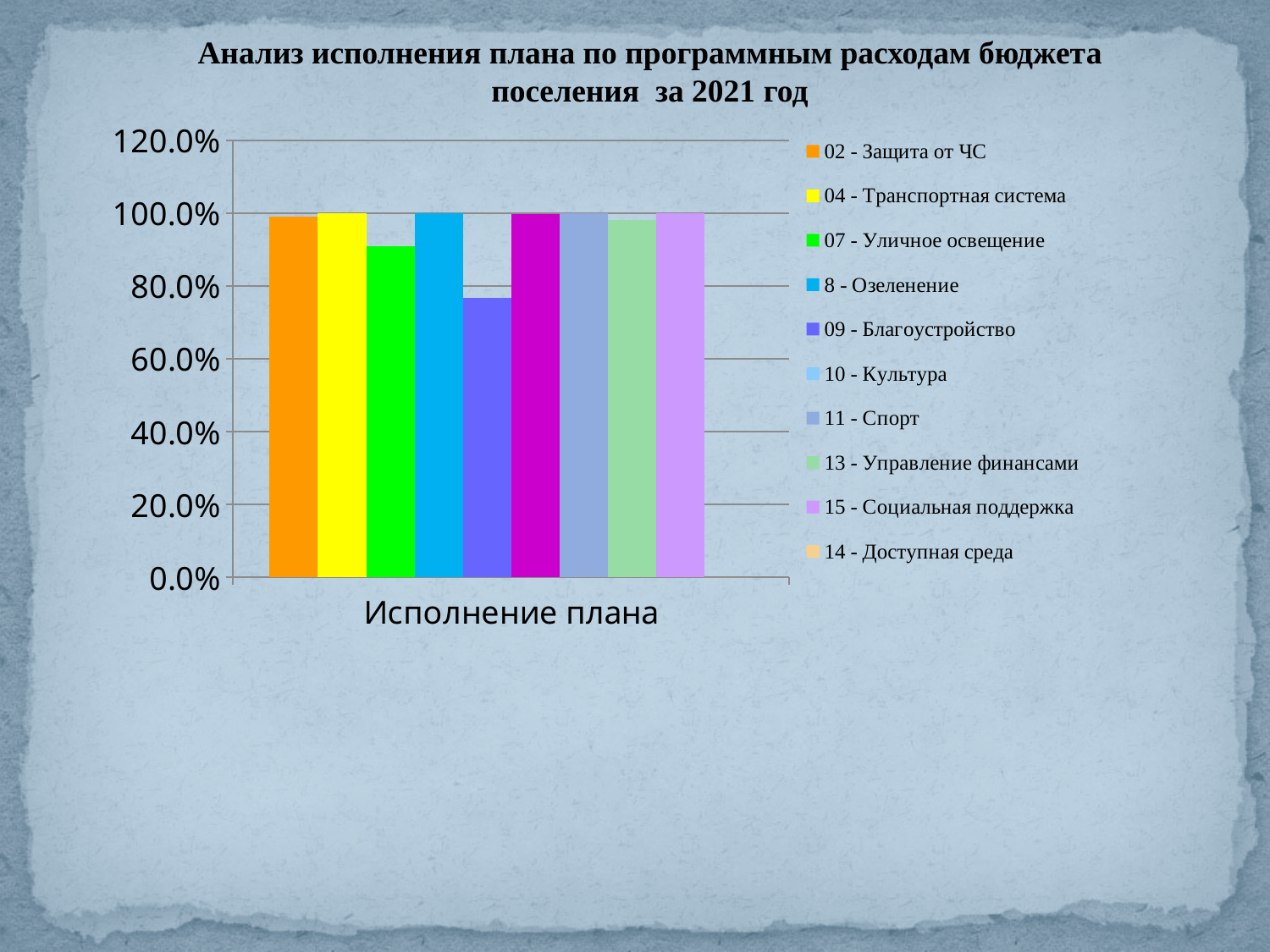
How many categories are shown on the x axis? 1 Which is larger, the value for 07 - Уличное освещение or the value for 09 - Благоустройство? 07 - Уличное освещение Is the value for 09 - Благоустройство greater or less than 60.0%? greater Is the value for 07 - Уличное освещение greater or less than 100.0%? less Which is larger, the value for 04 - Транспортная система or the value for 09 - Благоустройство? 04 - Транспортная система Is the value for 09 - Благоустройство greater or less than 80.0%? less How many series does the legend list? 10 What is the label of the single category on the x axis? Исполнение плана What kind of chart is shown on the slide? bar chart What is the title of the chart? Анализ исполнения плана по программным расходам бюджета поселения за 2021 год